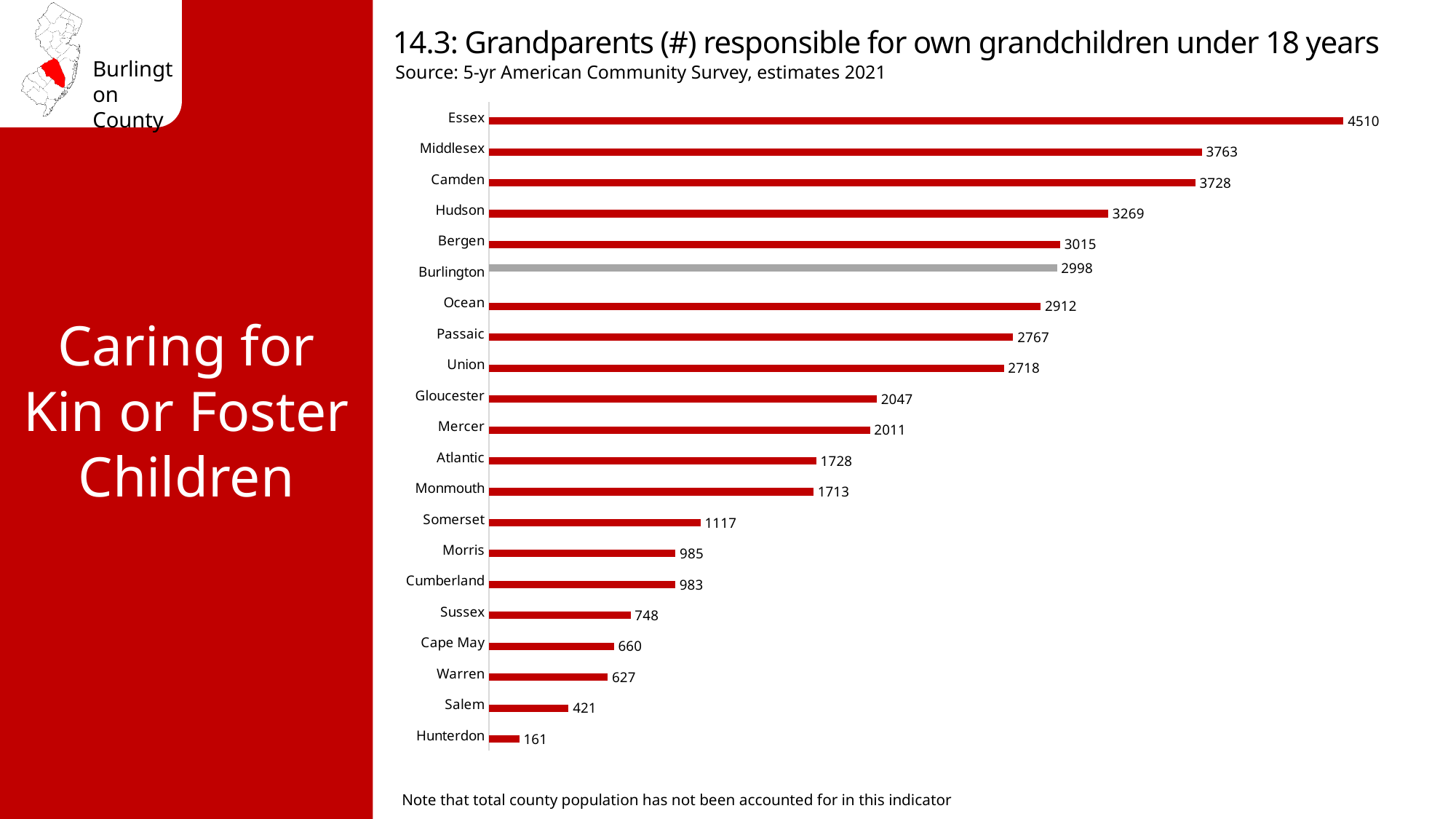
Which is larger, the value for Gloucester or the value for Atlantic? Gloucester What is the difference between the values for Essex and Middlesex? 747 What kind of chart is shown on the slide? Bar chart What is the value for Burlington? 2998 Which county's bar is shown in grey rather than red? Burlington What is the difference between the values for Burlington and Ocean? 86 Which county has the lowest value? Hunterdon What is the value for Hudson? 3269 What is the value for Somerset? 1117 How many counties are shown in the chart? 21 Which county has the highest value? Essex Which is larger, the value for Sussex or the value for Salem? Sussex